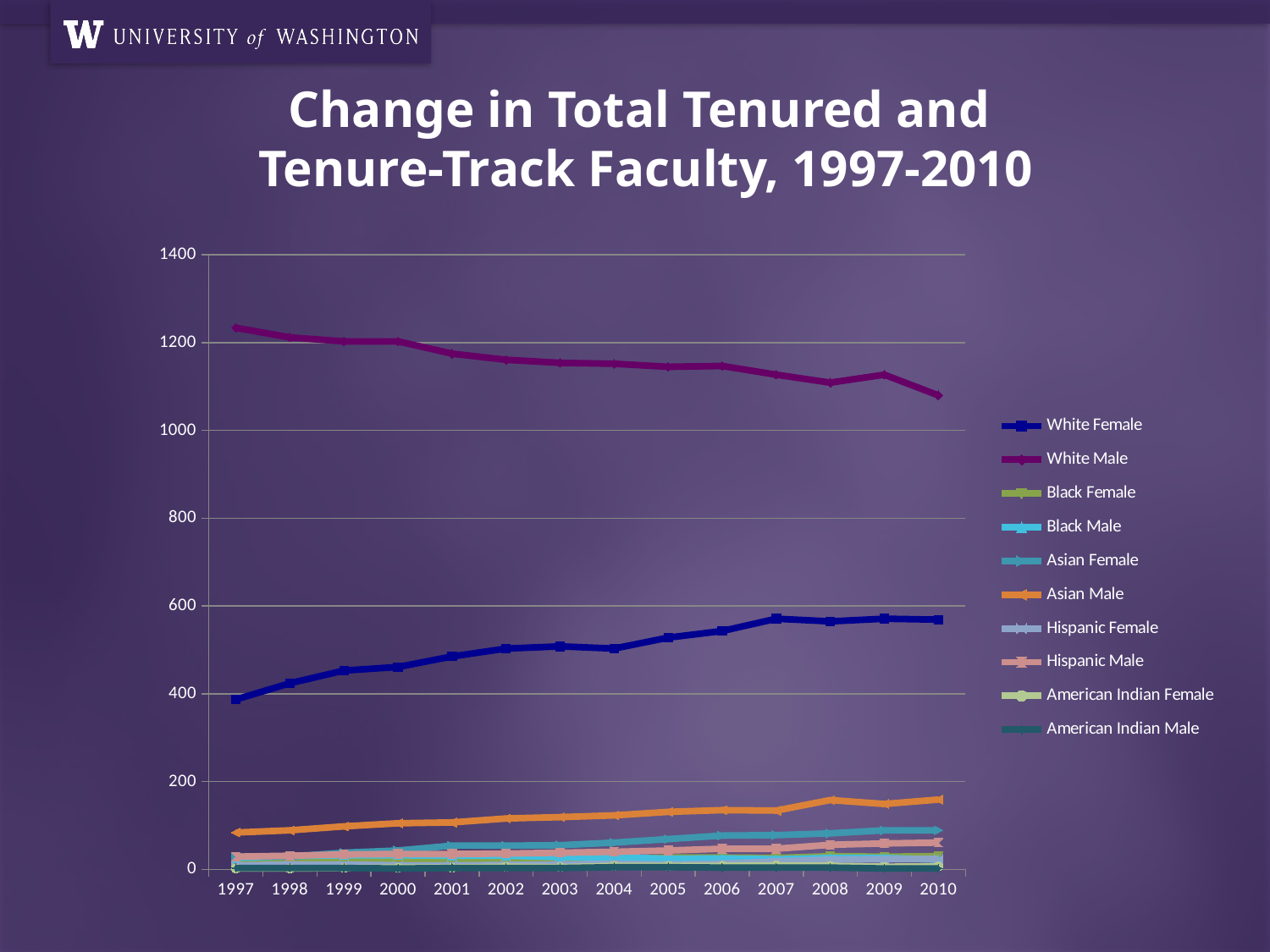
Does the White Female line rise or fall from 1997 to 2010? rise How many series does the legend list? 10 Is the value for White Male in 2010 greater or less than 1000? greater Is the value for Asian Male in 2010 greater or less than 200? less What is the first year shown on the x axis? 1997 Is the value for White Female in 2010 greater or less than 600? less Which series has the highest values throughout the chart? White Male In 2010, which is larger: the value for White Male or the value for White Female? White Male Does the White Male line rise or fall from 1997 to 2010? fall What kind of chart is shown on the slide? line chart What is the title of the chart? Change in Total Tenured and Tenure-Track Faculty, 1997-2010 How many years are plotted along the x axis? 14